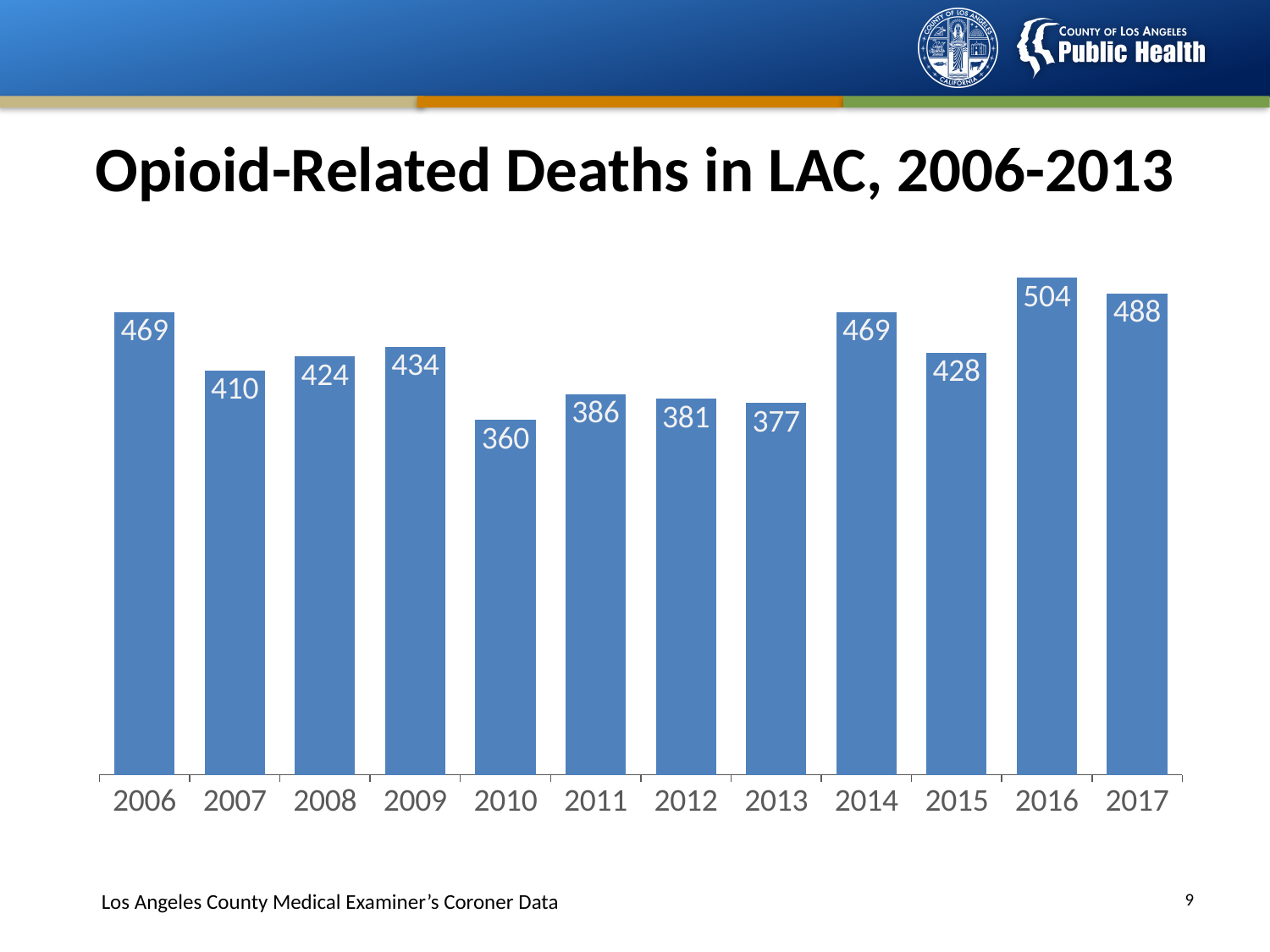
What is the number of opioid-related deaths shown for 2010? 360 What is the title of the chart? Opioid-Related Deaths in LAC, 2006-2013 What is the value shown for 2013? 377 Which is larger, the value for 2009 or the value for 2011? 2009 Which year has the lowest number of opioid-related deaths? 2010 Which year has the highest number of opioid-related deaths? 2016 Do the values rise or fall from 2014 to 2015? Fall What is the value shown for 2016? 504 What kind of chart is this? Bar chart How many years are shown on the x axis? 12 What is the difference between the values for 2016 and 2010? 144 What is the difference between the values for 2017 and 2015? 60